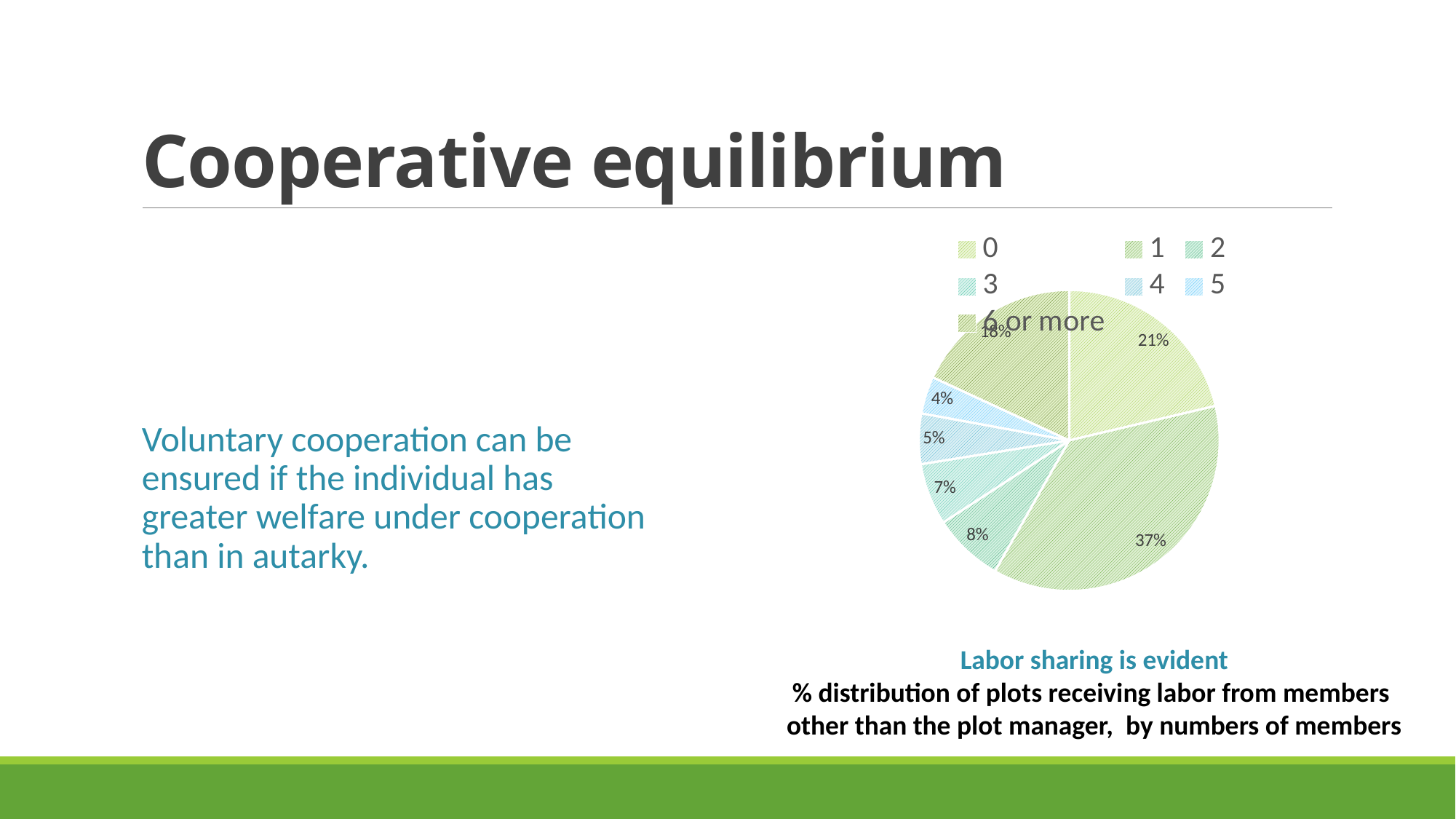
Which is larger: the share for 3 members or the share for 4 members? 3 members What kind of chart is shown on the slide? pie chart What percentage of plots received labor from 1 member? 37% How many entries does the legend of the pie chart list? 7 Which category has the smallest share of the pie? 5 What is the difference between the share for 1 member and the share for 0 members? 16% What percentage of plots received labor from 6 or more members? 18% How many slices does the pie chart have? 7 What percentage of plots received labor from 0 members? 21% What is the last entry listed in the pie chart's legend? 6 or more Which category has the largest share of the pie? 1 What percentage of plots received labor from 2 members? 8%